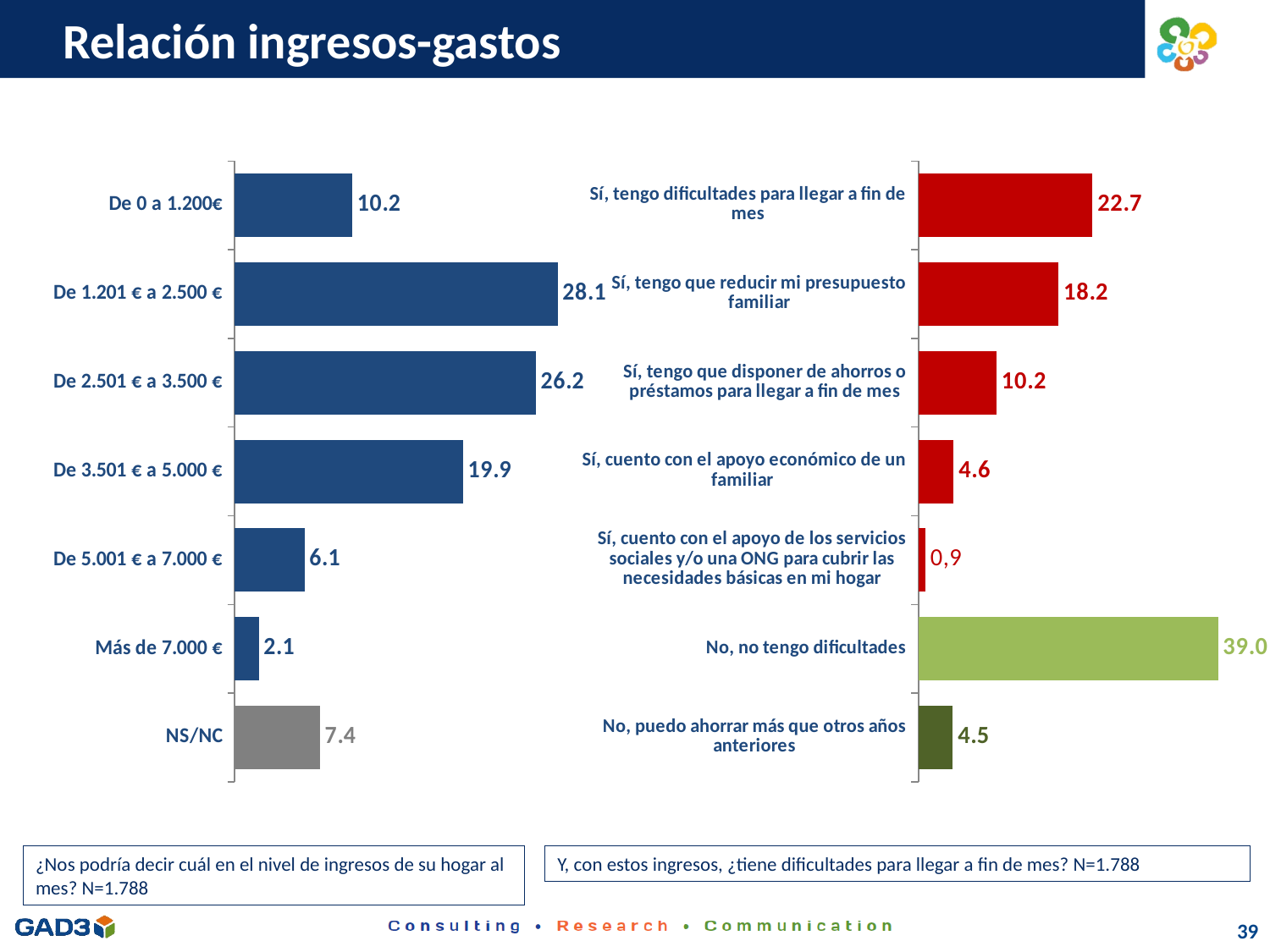
In the left chart, how many categories are shown? 7 What kind of chart is the right chart? Bar chart In the right chart, which is larger: 'Sí, tengo dificultades para llegar a fin de mes' or 'Sí, tengo que disponer de ahorros o préstamos para llegar a fin de mes'? Sí, tengo dificultades para llegar a fin de mes In the right chart, which category has the lowest value? Sí, cuento con el apoyo de los servicios sociales y/o una ONG para cubrir las necesidades básicas en mi hogar In the right chart, what is the difference between 'Sí, tengo dificultades para llegar a fin de mes' and 'Sí, tengo que reducir mi presupuesto familiar'? 4.5 In the left chart, which category has the highest value? De 1.201 € a 2.500 € In the left chart, what is the difference between 'De 2.501 € a 3.500 €' and 'De 3.501 € a 5.000 €'? 6.3 In the right chart, what is the value for 'No, no tengo dificultades'? 39.0 In the left chart, which category has the lowest value? Más de 7.000 € In the left chart, what is the value for 'De 1.201 € a 2.500 €'? 28.1 In the left chart, what is the value for 'NS/NC'? 7.4 In the right chart, what is the value for 'Sí, tengo que reducir mi presupuesto familiar'? 18.2